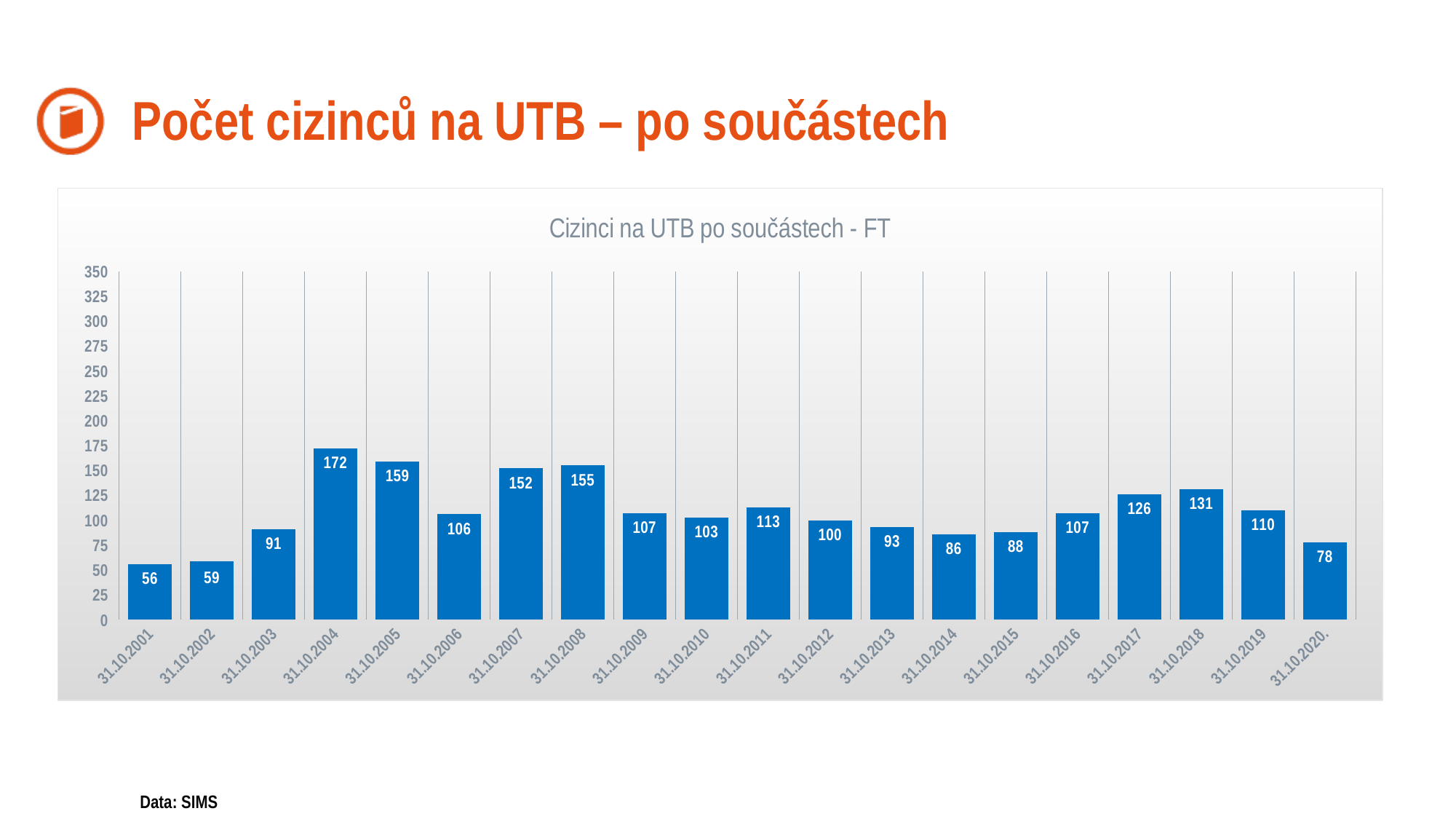
Which date has the highest value? 31.10.2004 What type of chart is shown on the slide? bar chart How many bars (dates) are plotted in the chart? 20 What is the value for 31.10.2012? 100 What is the difference between the values for 31.10.2019 and 31.10.2020? 32 What is the value for 31.10.2004? 172 Is the value for 31.10.2005 greater or less than 150? greater What is the title of the chart? Cizinci na UTB po součástech - FT What is the value for 31.10.2020? 78 Which is larger, the value for 31.10.2018 or the value for 31.10.2019? 31.10.2018 Which date has the lowest value? 31.10.2001 What is the difference between the values for 31.10.2004 and 31.10.2001? 116